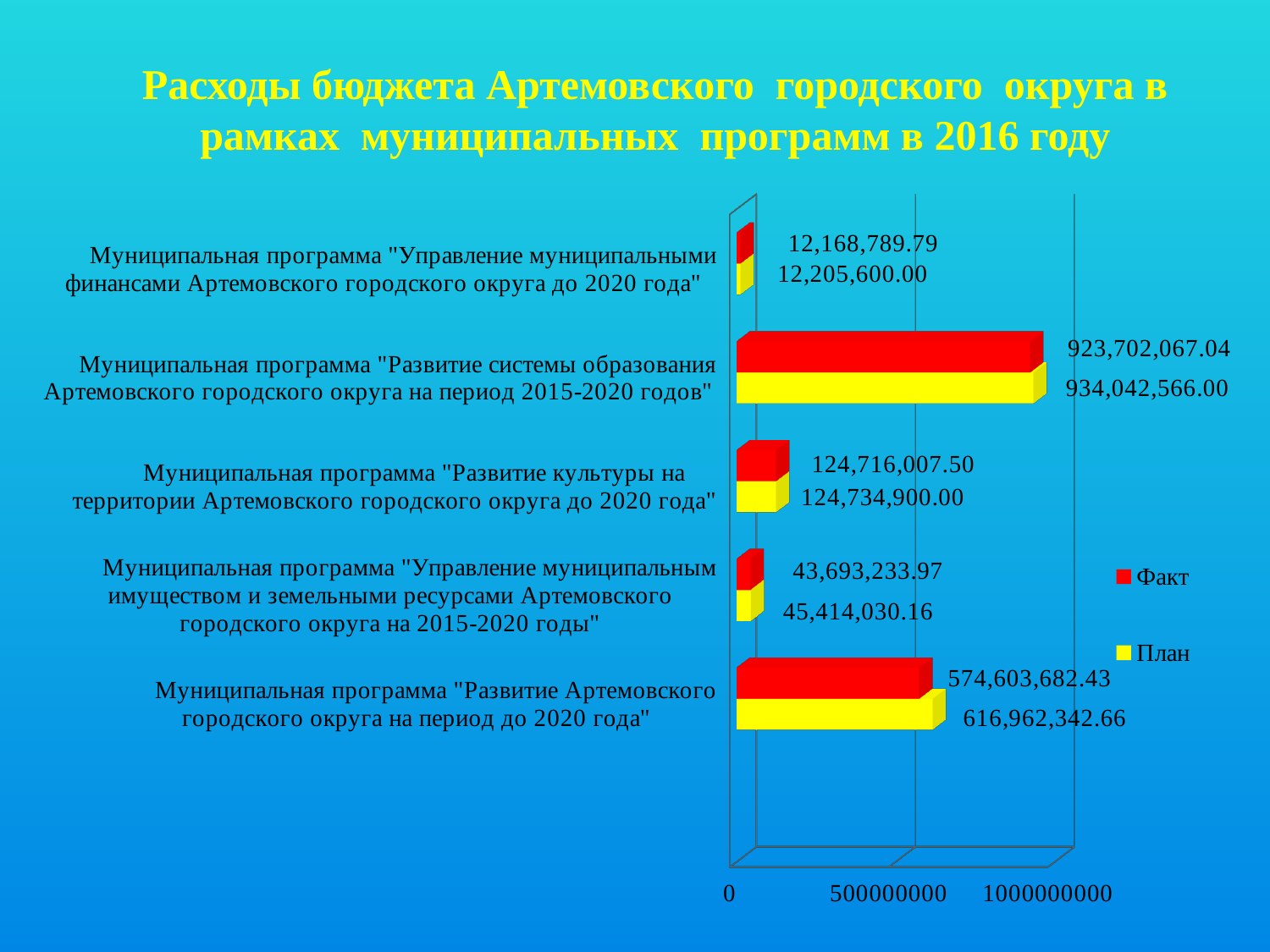
Which is larger for the program "Развитие культуры на территории Артемовского городского округа до 2020 года": the Факт value or the План value? План What type of chart is shown on the slide? Bar chart What is the Факт value for the program "Развитие системы образования Артемовского городского округа на период 2015-2020 годов"? 923,702,067.04 What is the difference between the План and Факт values for the program "Развитие Артемовского городского округа на период до 2020 года"? 42,358,660.23 What is the План value for the program "Управление муниципальными финансами Артемовского городского округа до 2020 года"? 12,205,600.00 Which program has the lowest План value? Муниципальная программа "Управление муниципальными финансами Артемовского городского округа до 2020 года" How many series does the legend list? 2 What is the difference between the План and Факт values for the program "Развитие системы образования Артемовского городского округа на период 2015-2020 годов"? 10,340,498.96 How many programs (categories) are shown in the chart? 5 What is the План value for the program "Развитие Артемовского городского округа на период до 2020 года"? 616,962,342.66 Which program has the highest Факт value? Муниципальная программа "Развитие системы образования Артемовского городского округа на период 2015-2020 годов" What is the Факт value for the program "Управление муниципальным имуществом и земельными ресурсами Артемовского городского округа на 2015-2020 годы"? 43,693,233.97